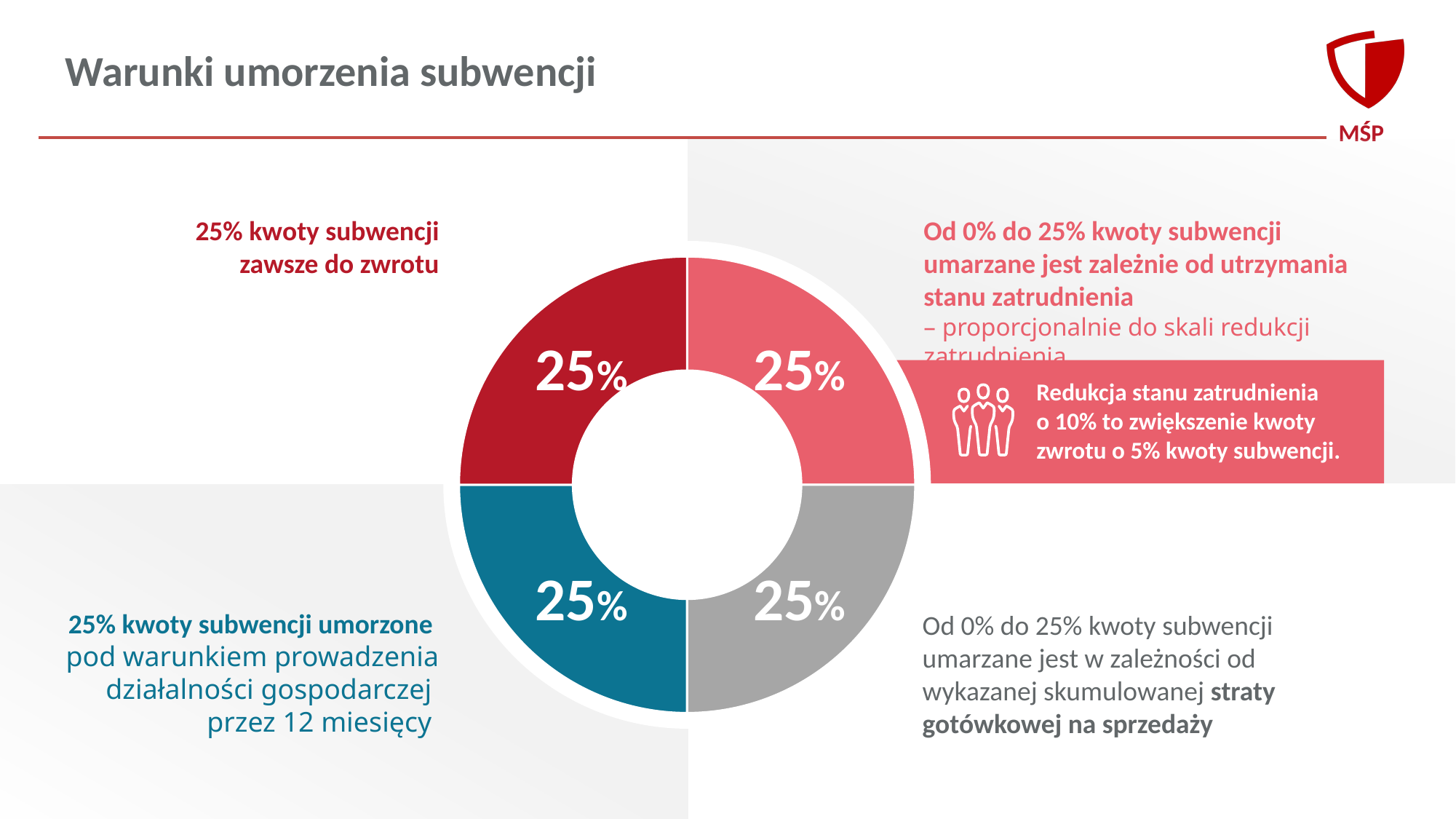
What value is printed on the light red (pink) slice of the chart? 25% What is the difference between the value of the blue slice and the value of the grey slice? 0% What kind of chart is shown on the slide? donut (pie) chart How many slices does the donut chart have? 4 What value is printed on the dark red slice of the chart? 25% Do all four slices of the chart have the same value? Yes What is the title of the slide containing the chart? Warunki umorzenia subwencji What colour is the slice associated with the text '25% kwoty subwencji umorzone pod warunkiem prowadzenia działalności gospodarczej przez 12 miesięcy'? blue What is the total of all four slice values in the chart? 100% What value is printed on the grey slice of the chart? 25% What value is printed on the blue slice of the chart? 25% What share of the chart does the slice labelled '25% kwoty subwencji zawsze do zwrotu' represent? 25%